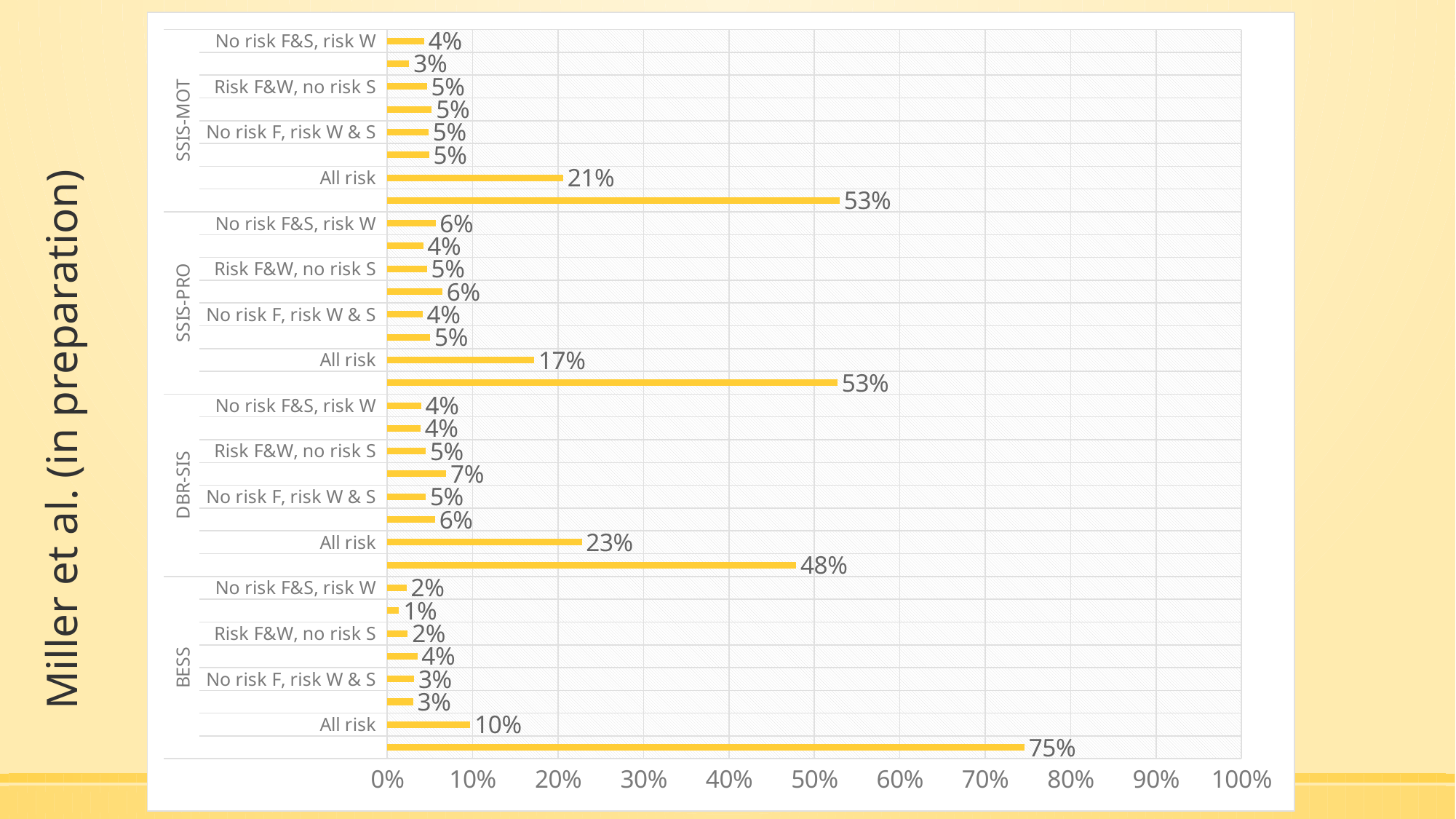
What is the difference between the "All risk" values for DBR-SIS and SSIS-PRO? 6 percentage points What is the value for "All risk" in the DBR-SIS group? 23% What is the value for "No risk F, risk W & S" in the BESS group? 3% Which group has the highest "All risk" value? DBR-SIS What is the value for "No risk F&S, risk W" in the SSIS-PRO group? 6% What is the value for "All risk" in the BESS group? 10% Which group has the lowest "All risk" value? BESS Which is larger: the "All risk" value for SSIS-MOT or for SSIS-PRO? SSIS-MOT What is the value for "All risk" in the SSIS-PRO group? 17% What kind of chart is shown on the slide? bar chart How many measure groups (SSIS-MOT, SSIS-PRO, DBR-SIS, BESS) are shown on the vertical axis? 4 What is the value for "All risk" in the SSIS-MOT group? 21%